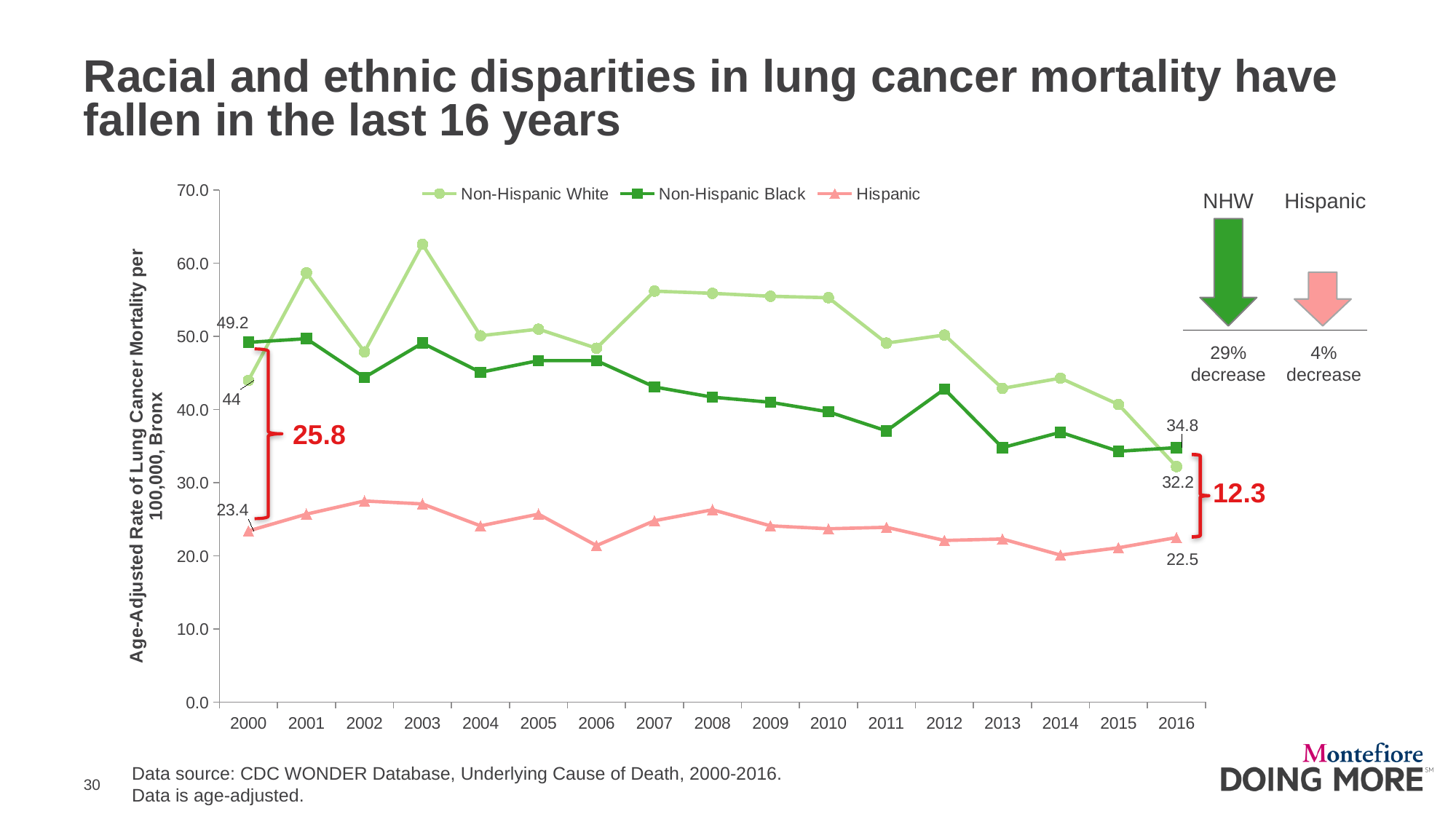
What was the age-adjusted lung cancer mortality rate for Non-Hispanic Black residents in 2016? 34.8 What is the difference between the Non-Hispanic Black rate and the Hispanic rate in 2000? 25.8 What was the age-adjusted lung cancer mortality rate for Non-Hispanic Black residents in 2000? 49.2 Is the Non-Hispanic White rate in 2003 greater or less than 60.0? greater How many years are plotted along the x axis? 17 What was the age-adjusted lung cancer mortality rate for Hispanic residents in 2016? 22.5 What was the age-adjusted lung cancer mortality rate for Non-Hispanic White residents in 2000? 44 What type of chart is shown on the slide? line chart Does the Non-Hispanic Black mortality rate generally rise or fall from 2000 to 2016? fall How many series does the legend list? 3 Which series had the lowest mortality rate in 2016? Hispanic What is the difference between the Non-Hispanic Black rate and the Hispanic rate in 2016? 12.3